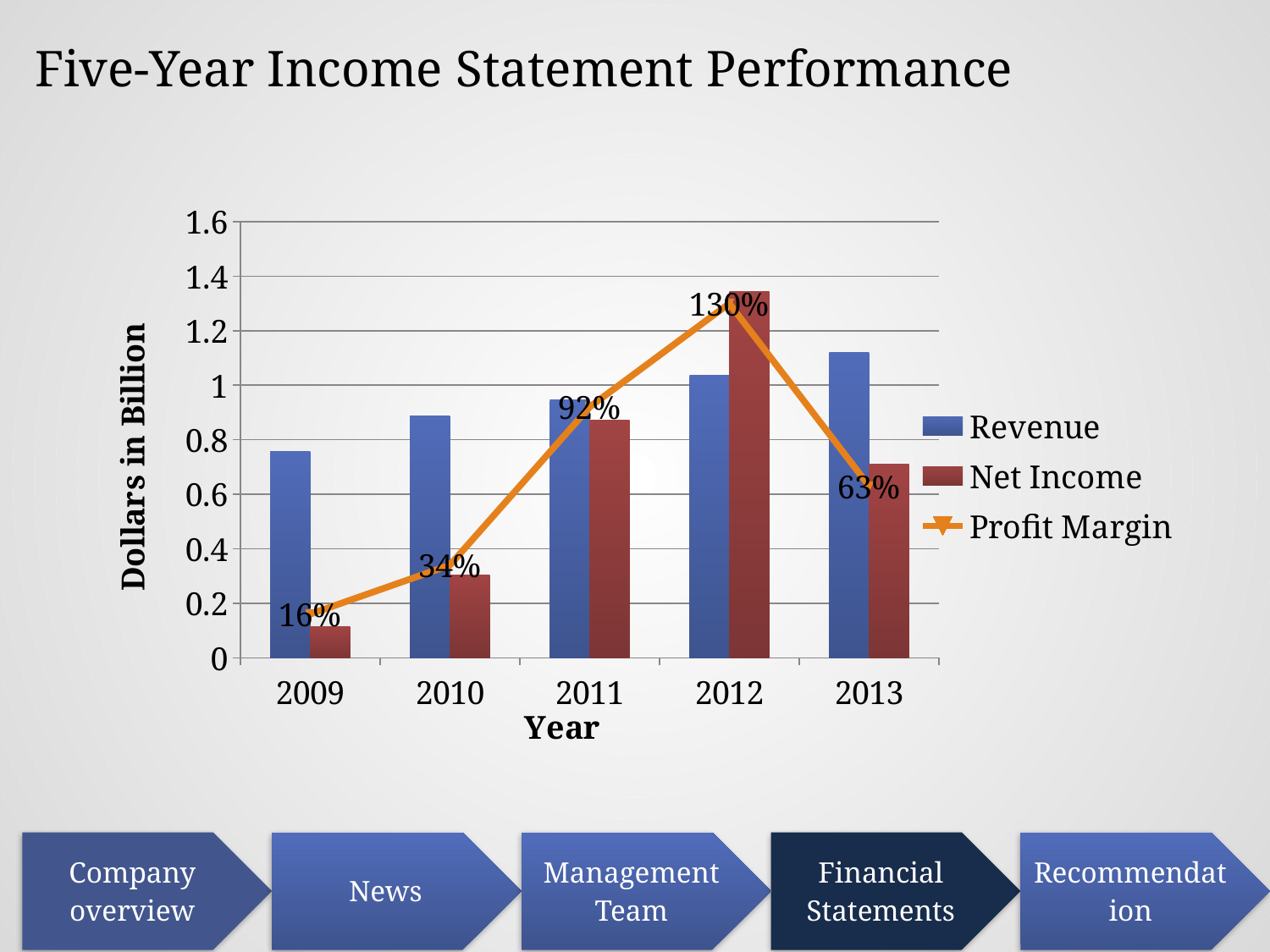
What is the Profit Margin for 2011? 92% In 2012, which is larger, Revenue or Net Income? Net Income Is the Net Income for 2012 greater or less than 1.2? greater Which year has the lowest Revenue? 2009 How many series does the legend list? 3 What is the Profit Margin for 2009? 16% How many years are shown on the x axis? 5 Which year has the highest Profit Margin? 2012 By how many percentage points does the Profit Margin in 2012 exceed the Profit Margin in 2011? 38 percentage points What is the Profit Margin for 2012? 130% Is the Revenue for 2009 greater or less than 0.8? less Does Revenue rise or fall from 2009 to 2013? rise